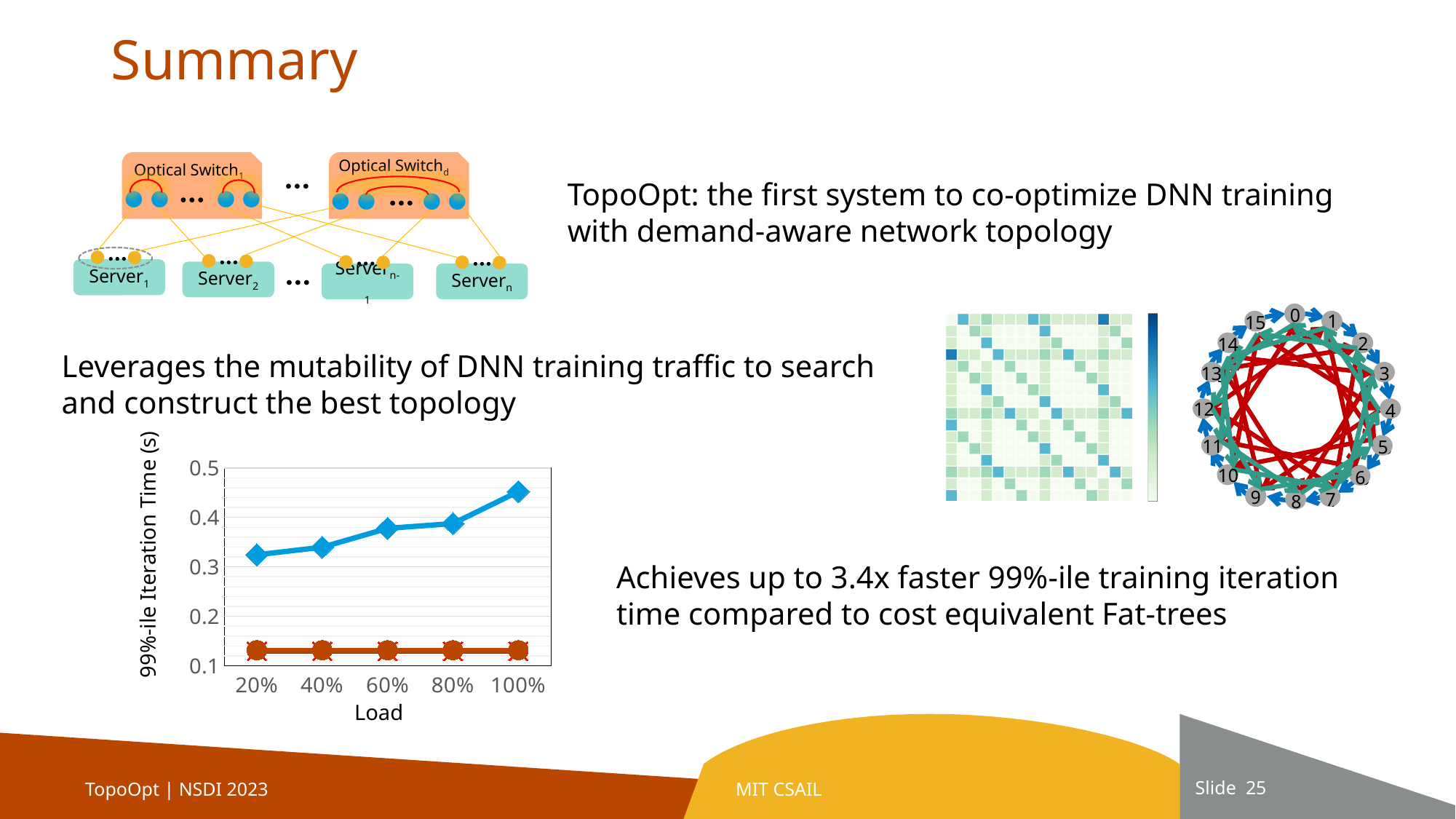
Is the value of the blue diamond-marker line at 40% load greater or less than 0.3? greater How many load levels are plotted along the x axis of the chart? 5 Which is larger for the blue diamond-marker line: the value at 20% load or the value at 100% load? 100% load What is the label of the y axis of the chart? 99%-ile Iteration Time (s) What is the label of the x axis of the chart? Load Is the value of the blue diamond-marker line at 100% load greater or less than 0.4? greater At which load does the blue diamond-marker line reach its highest value? 100% What kind of chart is shown on the slide? line chart At which load does the blue diamond-marker line have its lowest value? 20% Does the blue diamond-marker line rise or fall as load increases from 20% to 100%? rise At 80% load, which is larger: the blue diamond-marker line or the red/orange lines? the blue diamond-marker line Is the value of the red/orange lines at 60% load greater or less than 0.2? less